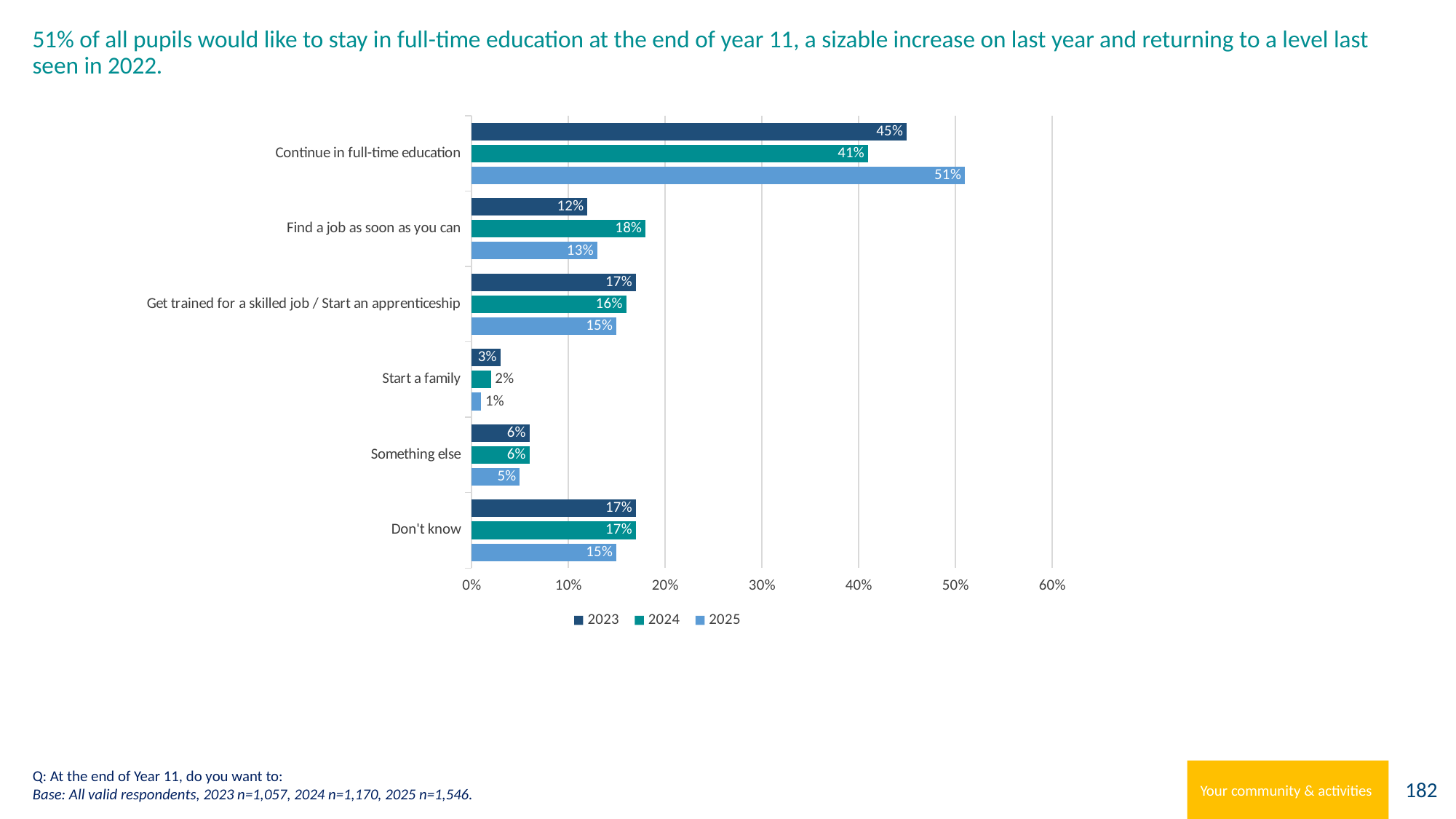
Which years are listed in the chart legend? 2023, 2024, 2025 What is the difference between the 2025 and 2024 values for 'Continue in full-time education'? 10 percentage points What was the value for 'Don't know' in 2025? 15% What kind of chart is shown on the slide? Bar chart Which category had the highest value in 2025? Continue in full-time education What was the value for 'Start a family' in 2023? 3% Which category had the lowest value in 2024? Start a family How many categories are shown on the chart? 6 What was the value for 'Find a job as soon as you can' in 2024? 18% How many series does the legend list? 3 What percentage of pupils in 2025 wanted to continue in full-time education? 51% Which is larger for 'Find a job as soon as you can': the 2023 value or the 2024 value? 2024